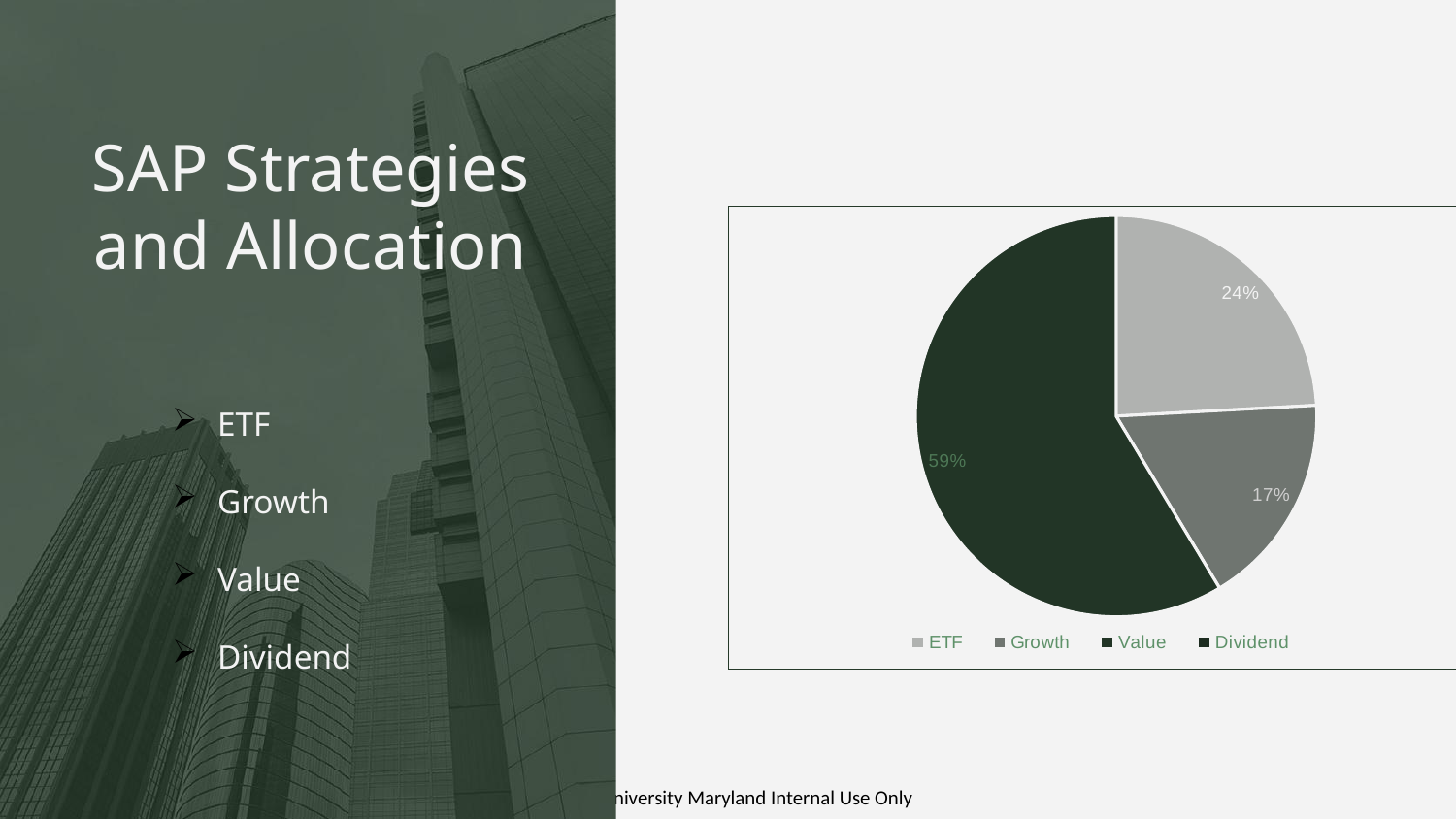
How many slices of the pie have a percentage label? 3 Is the largest slice of the pie greater or less than 50%? greater What is the percentage shown on the largest slice of the pie? 59% How many entries does the chart legend list? 4 What percentage of the pie is labelled for ETF? 24% What percentage of the pie is labelled for Growth? 17% Which has the larger share of the pie, ETF or Growth? ETF Which of ETF or Growth has the smaller share of the pie? Growth What are the entries listed in the chart legend, in order? ETF, Growth, Value, Dividend What share of the pie does ETF represent? 24% What is the difference between the ETF share and the Growth share? 7% What kind of chart is shown on the slide? pie chart